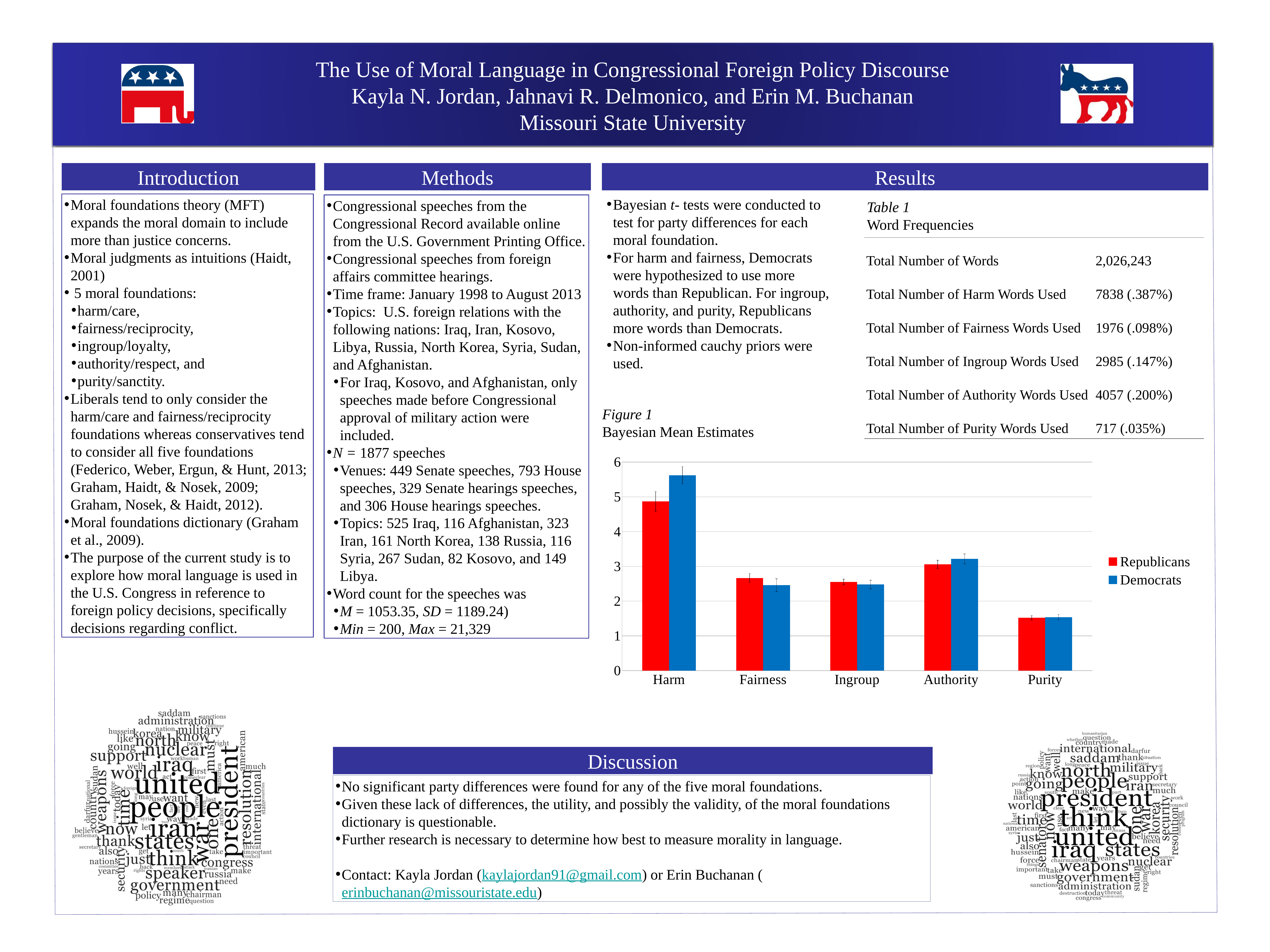
How many series does the legend of the Bayesian Mean Estimates chart list? 2 What is the title of the chart labelled Figure 1? Bayesian Mean Estimates In the Bayesian Mean Estimates chart, which category has the lowest value for Republicans? Purity In the Bayesian Mean Estimates chart, which category has the highest value for Republicans? Harm What kind of chart is Figure 1 (Bayesian Mean Estimates)? bar chart In the Bayesian Mean Estimates chart, for Harm, which party has the larger value, Republicans or Democrats? Democrats How many moral foundation categories are shown on the x axis of the Bayesian Mean Estimates chart? 5 In the Bayesian Mean Estimates chart, is the Republicans value for Purity greater or less than 2? less In the Bayesian Mean Estimates chart, is the Democrats value for Harm greater or less than 5? greater In the Bayesian Mean Estimates chart, which colour represents Republicans? red In the Bayesian Mean Estimates chart, which category has the highest value for Democrats? Harm